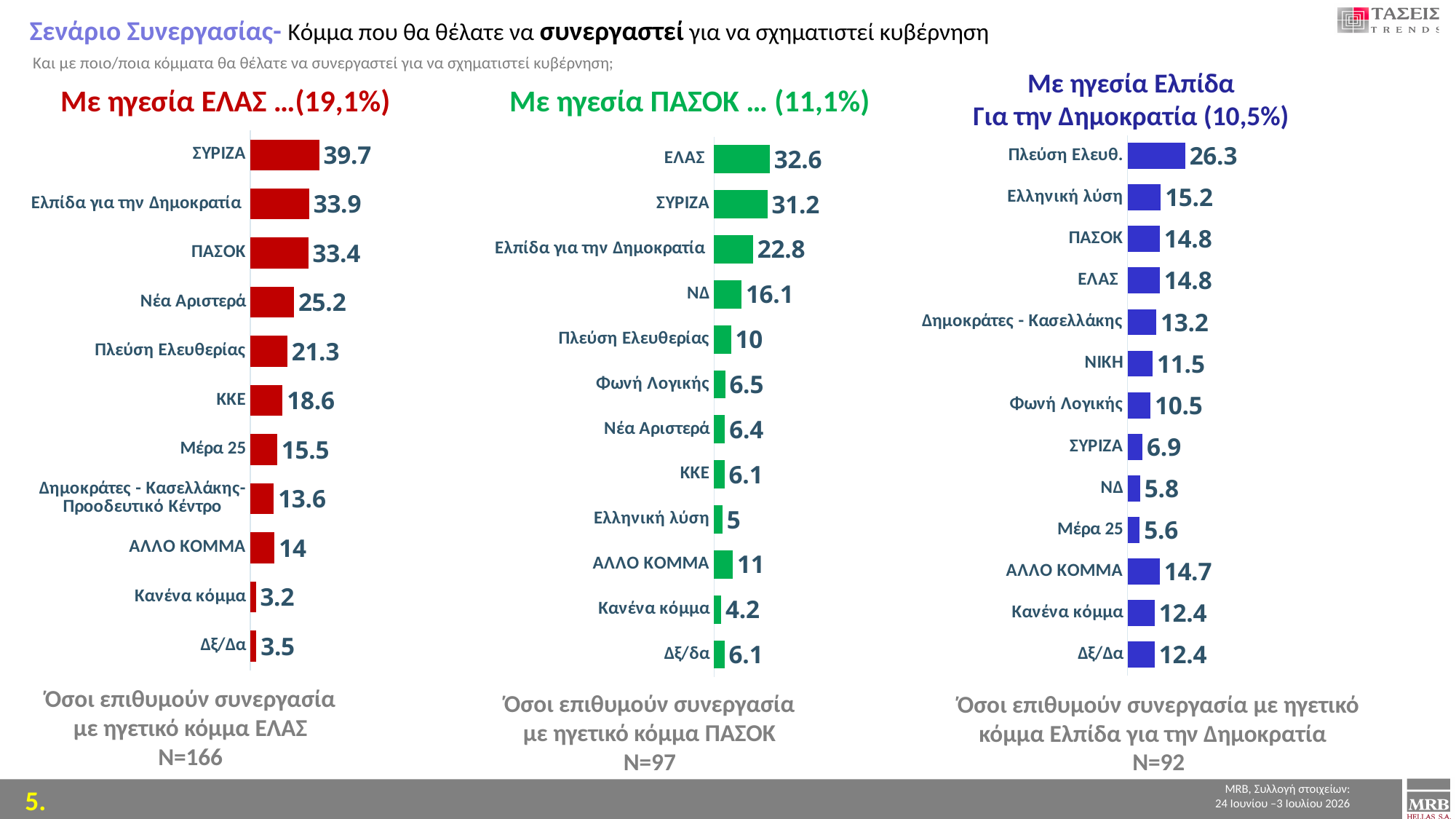
How many categories are plotted in the left chart (Με ηγεσία ΕΛΑΣ)? 11 In the left chart (Με ηγεσία ΕΛΑΣ), what is the value for ΣΥΡΙΖΑ? 39.7 In the middle chart (Με ηγεσία ΠΑΣΟΚ), which is larger: the value for Πλεύση Ελευθερίας or the value for ΑΛΛΟ ΚΟΜΜΑ? ΑΛΛΟ ΚΟΜΜΑ In the right chart (Με ηγεσία Ελπίδα Για την Δημοκρατία), which category has the highest value? Πλεύση Ελευθ. In the right chart (Με ηγεσία Ελπίδα Για την Δημοκρατία), what is the difference between the values for Πλεύση Ελευθ. and ΣΥΡΙΖΑ? 19.4 In the middle chart (Με ηγεσία ΠΑΣΟΚ), what is the value for ΝΔ? 16.1 What type of chart is the left chart (Με ηγεσία ΕΛΑΣ)? Bar chart How many categories are plotted in the middle chart (Με ηγεσία ΠΑΣΟΚ)? 12 In the left chart (Με ηγεσία ΕΛΑΣ), which category has the lowest value? Κανένα κόμμα In the right chart (Με ηγεσία Ελπίδα Για την Δημοκρατία), what is the value for Ελληνική λύση? 15.2 In the left chart (Με ηγεσία ΕΛΑΣ), what is the difference between the values for ΣΥΡΙΖΑ and ΠΑΣΟΚ? 6.3 In the middle chart (Με ηγεσία ΠΑΣΟΚ), which category has the highest value? ΕΛΑΣ